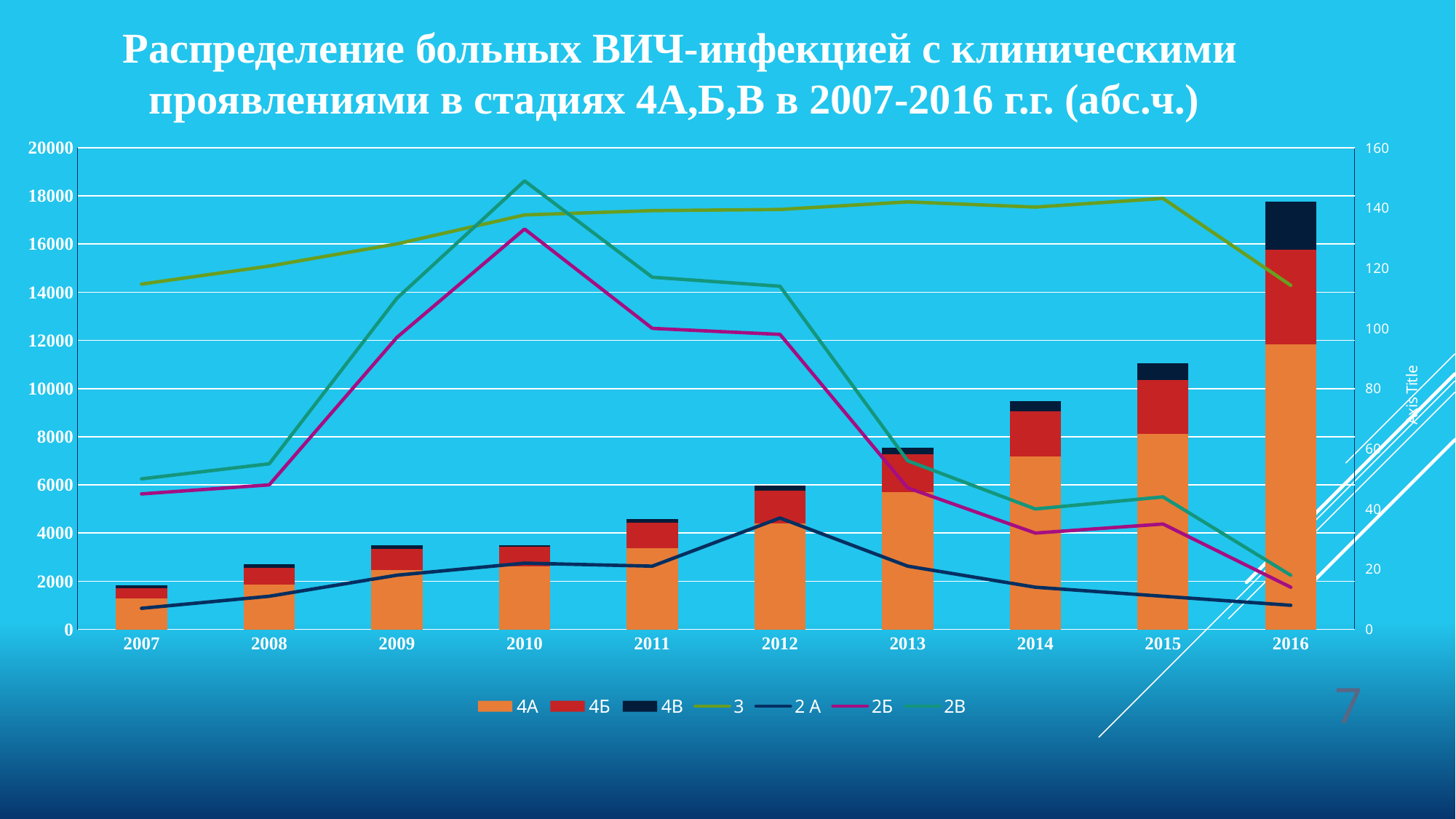
Which year has the shortest stacked bar? 2007 In which year does the 2В line reach its highest point? 2010 Is the total height of the stacked bar for 2016 greater or less than 16000? greater Is the total height of the stacked bar for 2014 greater or less than 10000? less What colour represents the 4А series in the legend? orange How many years are shown on the x axis? 10 Do the stacked bar totals rise or fall from 2007 to 2016? rise What kind of chart is shown on the slide? A combination chart of stacked bars and lines How many series does the legend list? 7 Which year has the tallest stacked bar? 2016 Which stacked bar is taller, 2015 or 2014? 2015 In which year does the 2 А line reach its highest point? 2012